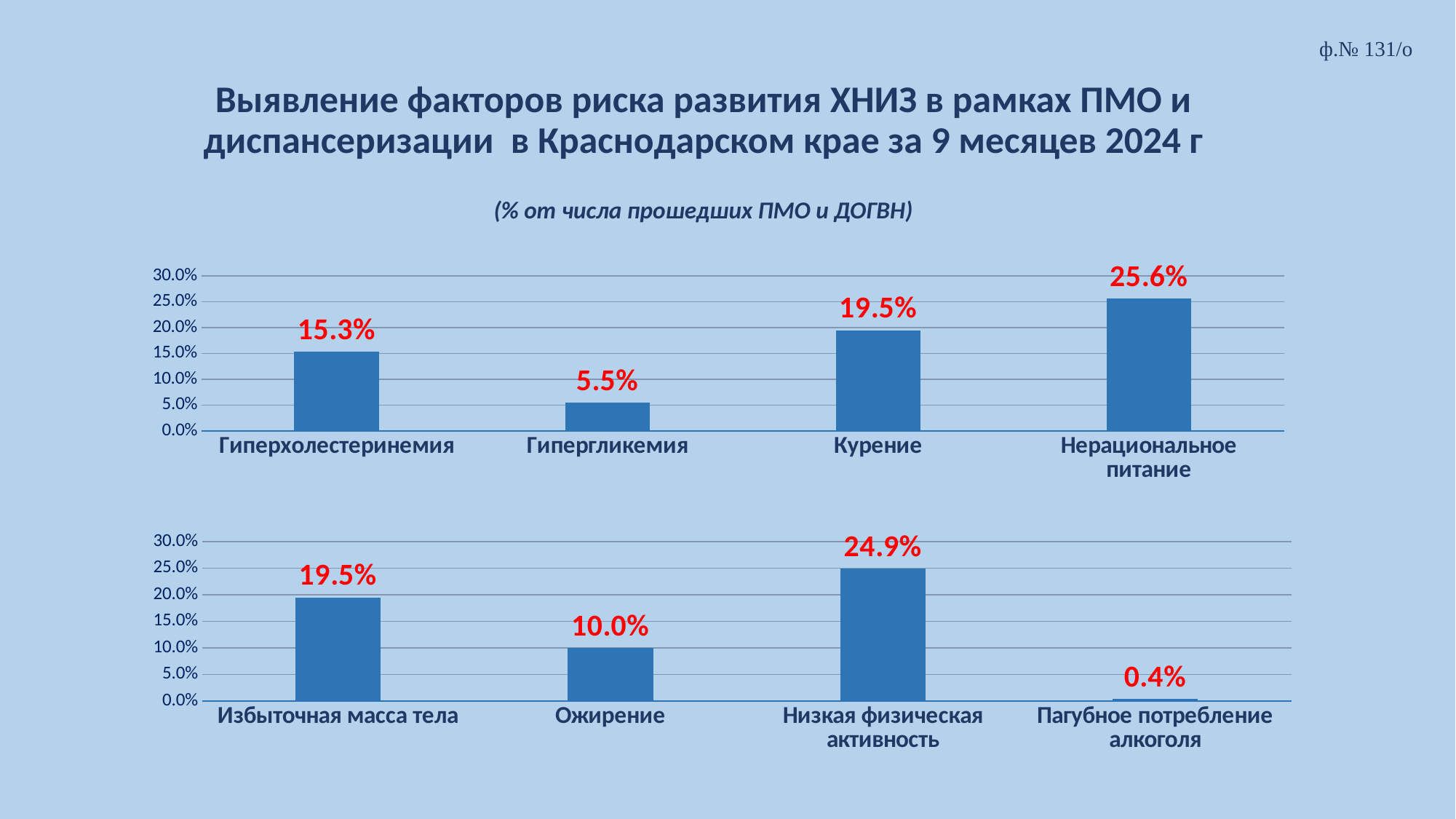
In the bottom chart, which is larger: the value for Избыточная масса тела or the value for Ожирение? Избыточная масса тела In the top chart, what is the difference between the values for Курение and Гиперхолестеринемия? 4.2% In the top chart, which category has the lowest value? Гипергликемия In the bottom chart, what is the value for Пагубное потребление алкоголя? 0.4% In the top chart, what is the value for Гипергликемия? 5.5% In the top chart, what is the value for Нерациональное питание? 25.6% How many categories are shown in the bottom chart? 4 In the top chart, which category has the highest value? Нерациональное питание In the bottom chart, which category has the lowest value? Пагубное потребление алкоголя In the bottom chart, what is the difference between the values for Низкая физическая активность and Ожирение? 14.9% What type of chart is the top chart? Bar chart In the bottom chart, what is the value for Низкая физическая активность? 24.9%